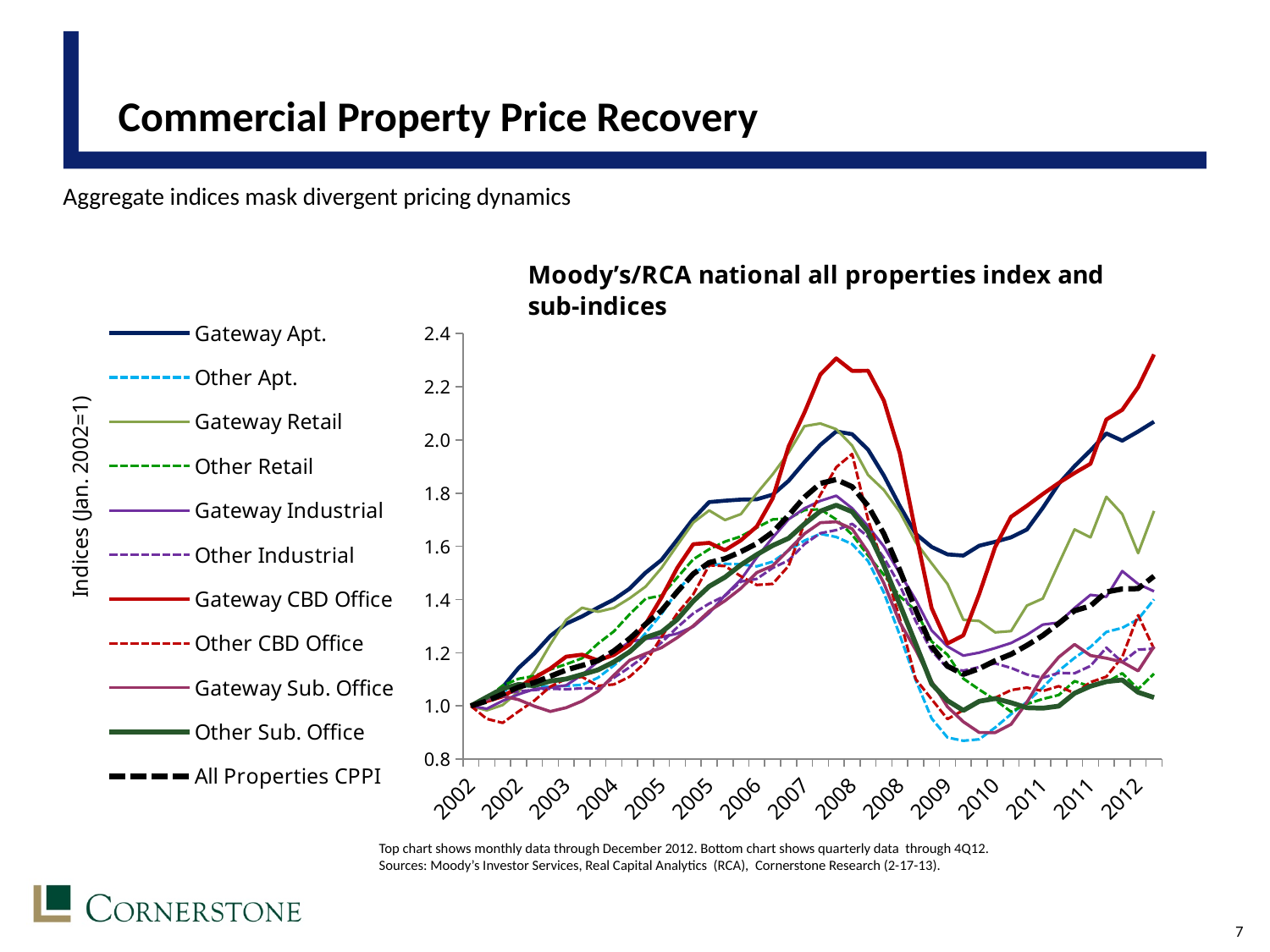
At the end of 2012, which is larger: Gateway Apt. or Gateway Retail? Gateway Apt. How many series does the legend list? 11 What kind of chart is shown on the slide? line chart Is the value of All Properties CPPI at the end of 2012 greater or less than 1.6? less Which series has the lowest value at the end of 2012? Other Sub. Office Which series reaches the highest value anywhere on the chart? Gateway CBD Office What is the title of the chart? Moody's/RCA national all properties index and sub-indices Does the All Properties CPPI series rise or fall between 2008 and 2009? fall Is the peak value of Gateway CBD Office in 2008 greater or less than 2.2? greater Which series has the highest value at the end of 2012? Gateway CBD Office Is the lowest value of Other Apt. in 2009 greater or less than 1.0? less What is the label on the vertical axis of the chart? Indices (Jan. 2002=1)